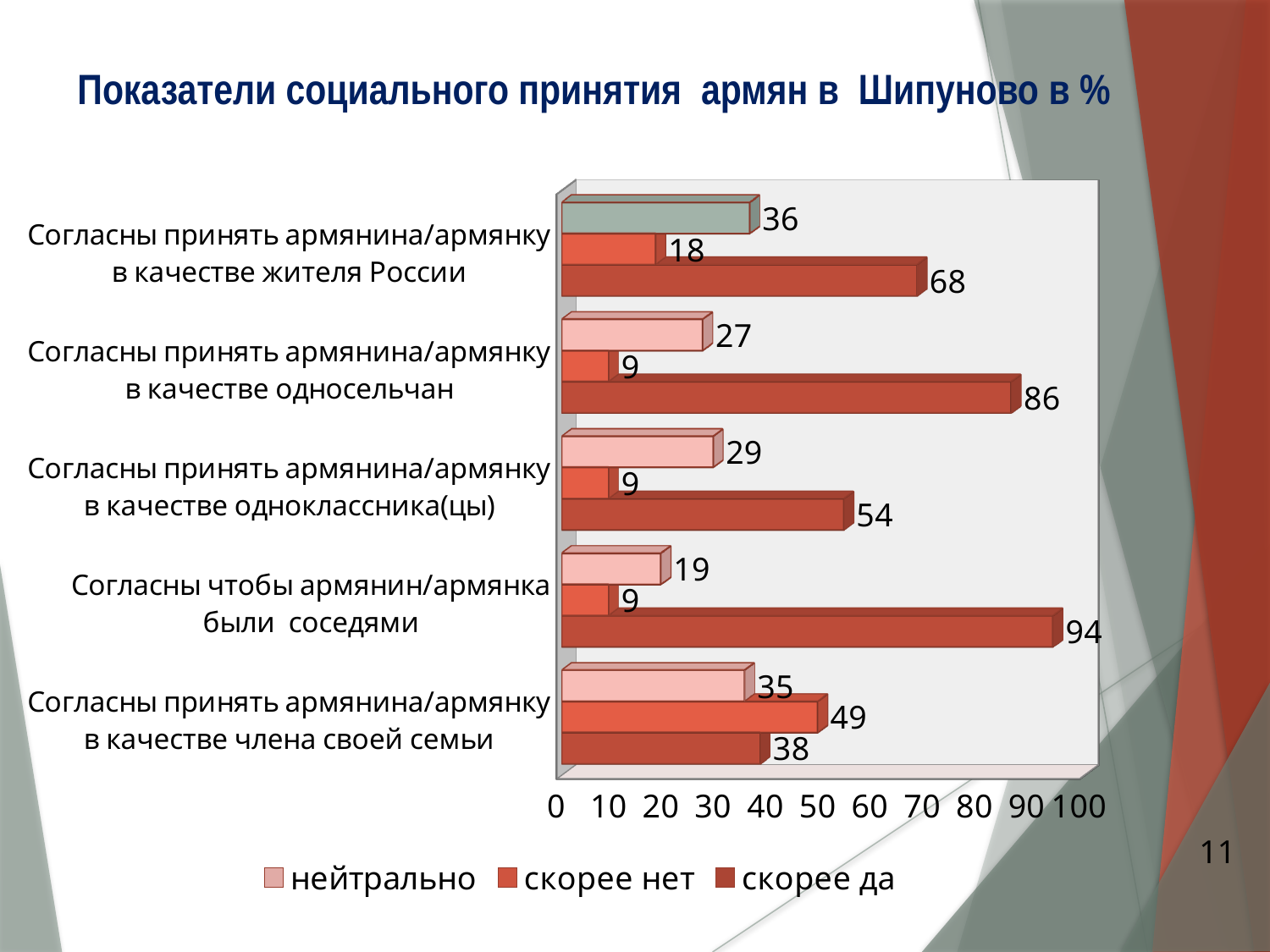
What is the value of «скорее нет» for «Согласны принять армянина/армянку в качестве члена своей семьи»? 49 What is the value of «скорее нет» for «Согласны принять армянина/армянку в качестве односельчан»? 9 Which category has the highest value for «скорее да»? Согласны чтобы армянин/армянка были соседями For «Согласны принять армянина/армянку в качестве члена своей семьи», which is larger: «скорее нет» or «скорее да»? скорее нет What is the value of «нейтрально» for «Согласны принять армянина/армянку в качестве жителя России»? 36 What is the title of the chart on the slide? Показатели социального принятия армян в Шипуново в % How many series does the legend list? 3 What type of chart is shown on the slide? bar chart What is the difference between «скорее да» for «в качестве односельчан» and «скорее да» for «в качестве одноклассника(цы)»? 32 Which category has the lowest value for «скорее да»? Согласны принять армянина/армянку в качестве члена своей семьи What is the value of «скорее да» for «Согласны чтобы армянин/армянка были соседями»? 94 How many categories are shown on the chart? 5